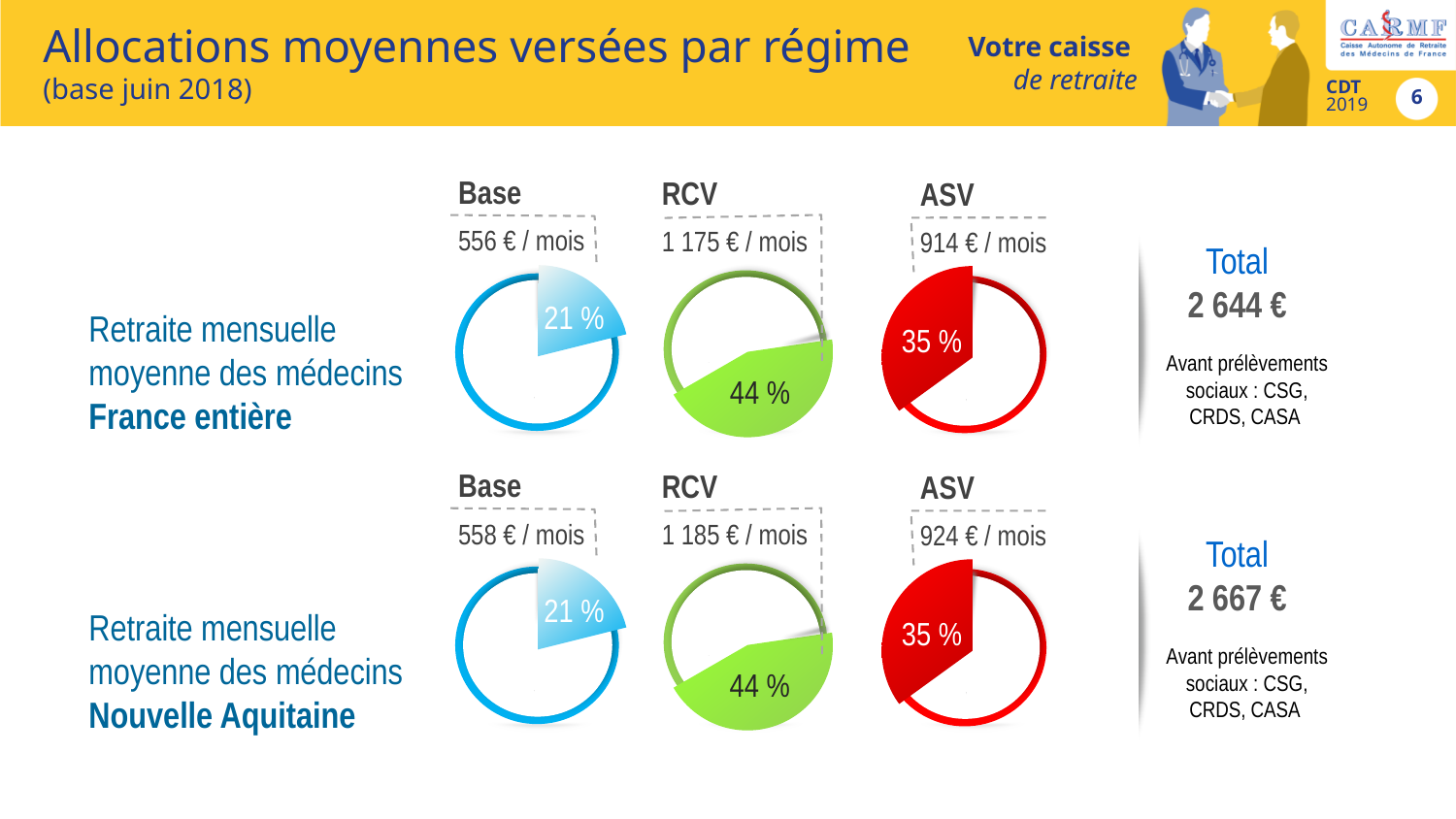
What is the total monthly retirement amount shown for Nouvelle Aquitaine? 2 667 € How many pie charts are shown in the France entière row? 3 What is the difference between the ASV monthly amount for Nouvelle Aquitaine and for France entière? 10 € In the France entière row, what is the monthly amount shown for the RCV regime? 1 175 € / mois Which is larger: the RCV monthly amount for France entière or for Nouvelle Aquitaine? Nouvelle Aquitaine In the France entière row, what percentage is shown on the RCV pie chart? 44 % In the Nouvelle Aquitaine row, which regime has the lowest monthly amount? Base In the France entière row, what is the monthly amount shown for the Base regime? 556 € / mois In the France entière row, which regime has the highest monthly amount? RCV In the Nouvelle Aquitaine row, what percentage is shown on the Base pie chart? 21 % In the Nouvelle Aquitaine row, what is the monthly amount shown for the ASV regime? 924 € / mois What colour is the ASV pie chart in each row? Red